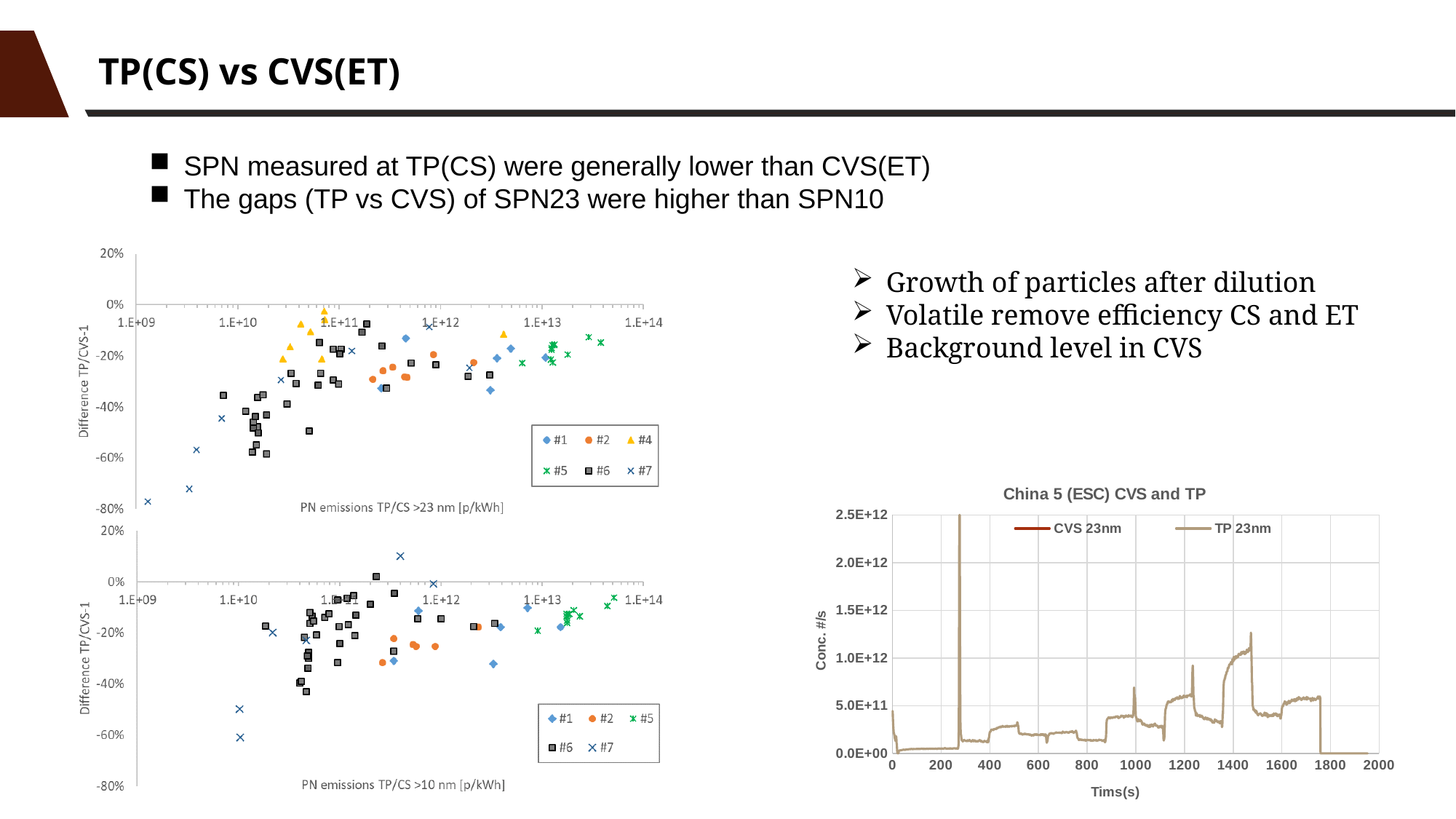
In the top-left chart (>23 nm), which series has the lowest plotted point? #7 In the 'China 5 (ESC) CVS and TP' chart, is the concentration after 1800 s greater or less than 5.0E+11? less How many series does the legend of the bottom-left chart (>10 nm) list? 5 What kind of chart is the top-left chart with x-axis 'PN emissions TP/CS >23 nm [p/kWh]'? scatter chart In the bottom-left chart (>10 nm), which series has the highest plotted point? #7 In the top-left chart (>23 nm), is the lowest #7 point greater or less than -60%? less What kind of chart is the chart titled 'China 5 (ESC) CVS and TP'? line chart In the 'China 5 (ESC) CVS and TP' chart, is the peak value near 280 s greater or less than 2.0E+12? greater How many series does the legend of the 'China 5 (ESC) CVS and TP' chart list? 2 How many series does the legend of the top-left chart (>23 nm) list? 6 What is the x-axis label of the 'China 5 (ESC) CVS and TP' chart? Tims(s) What is the y-axis label of the bottom-left chart (>10 nm)? Difference TP/CVS-1